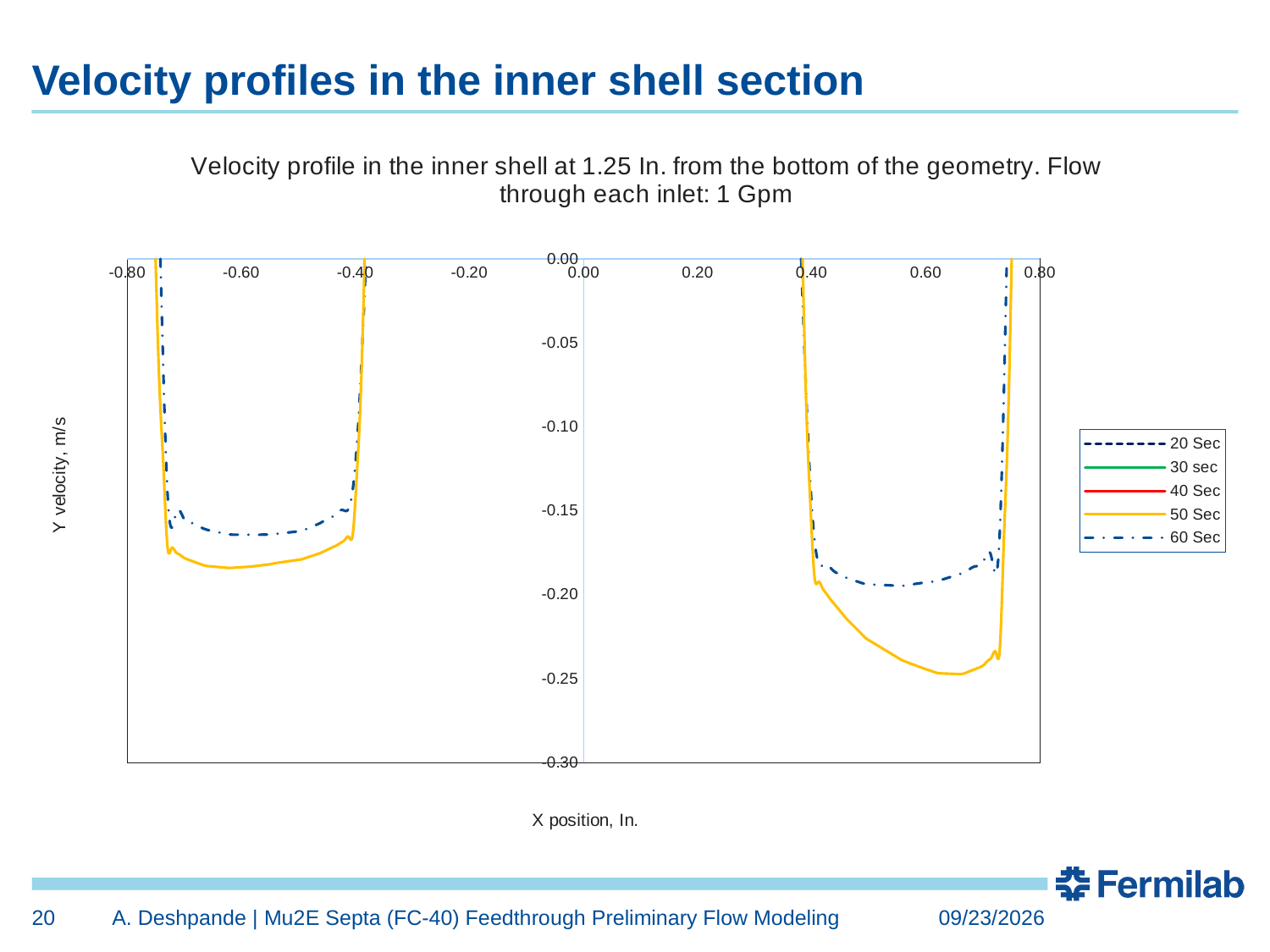
What kind of chart is shown on the slide? line chart How many series does the legend list? 5 What is the title of the chart? Velocity profile in the inner shell at 1.25 In. from the bottom of the geometry. Flow through each inlet: 1 Gpm Is the lowest value of the dashed blue series on the left side of the chart (x between -0.80 and -0.40) greater or less than -0.20? greater Which series in the legend is drawn in yellow? 50 Sec For the 50 Sec series, which side of the chart reaches the more negative Y velocity: the left side (negative x) or the right side (positive x)? right side Is the lowest value of the 50 Sec series on the right side of the chart (x between 0.40 and 0.80) greater or less than -0.20? less Is the lowest value of the dashed blue series on the right side of the chart (x between 0.40 and 0.80) greater or less than -0.15? less On the right side of the chart (x between 0.40 and 0.80), which series reaches the more negative Y velocity: the 50 Sec series or the dashed blue series? 50 Sec